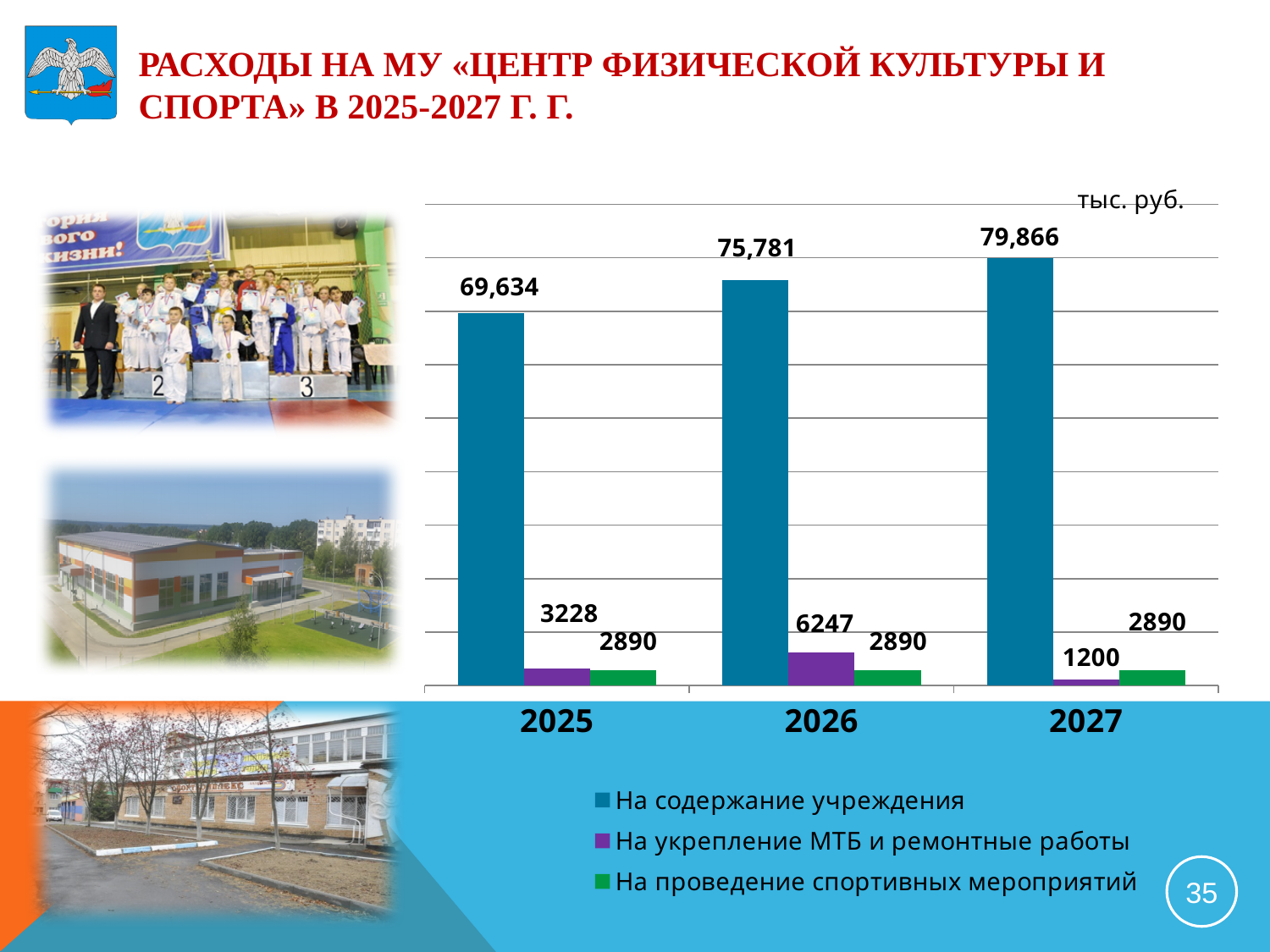
In which year is the value for "На содержание учреждения" the highest? 2027 How many series does the legend list? 3 What is the difference between the "На содержание учреждения" values for 2027 and 2025? 10,232 Which is larger in 2025: "На укрепление МТБ и ремонтные работы" or "На проведение спортивных мероприятий"? На укрепление МТБ и ремонтные работы How many years are shown on the x axis of the chart? 3 What is the value for "На содержание учреждения" in 2025? 69,634 What is the value for "На проведение спортивных мероприятий" in 2027? 2890 Do the values for "На содержание учреждения" rise or fall from 2025 to 2027? rise What kind of chart is shown on the slide? bar chart What is the value for "На укрепление МТБ и ремонтные работы" in 2026? 6247 What is the value for "На укрепление МТБ и ремонтные работы" in 2027? 1200 In which year is the value for "На укрепление МТБ и ремонтные работы" the lowest? 2027